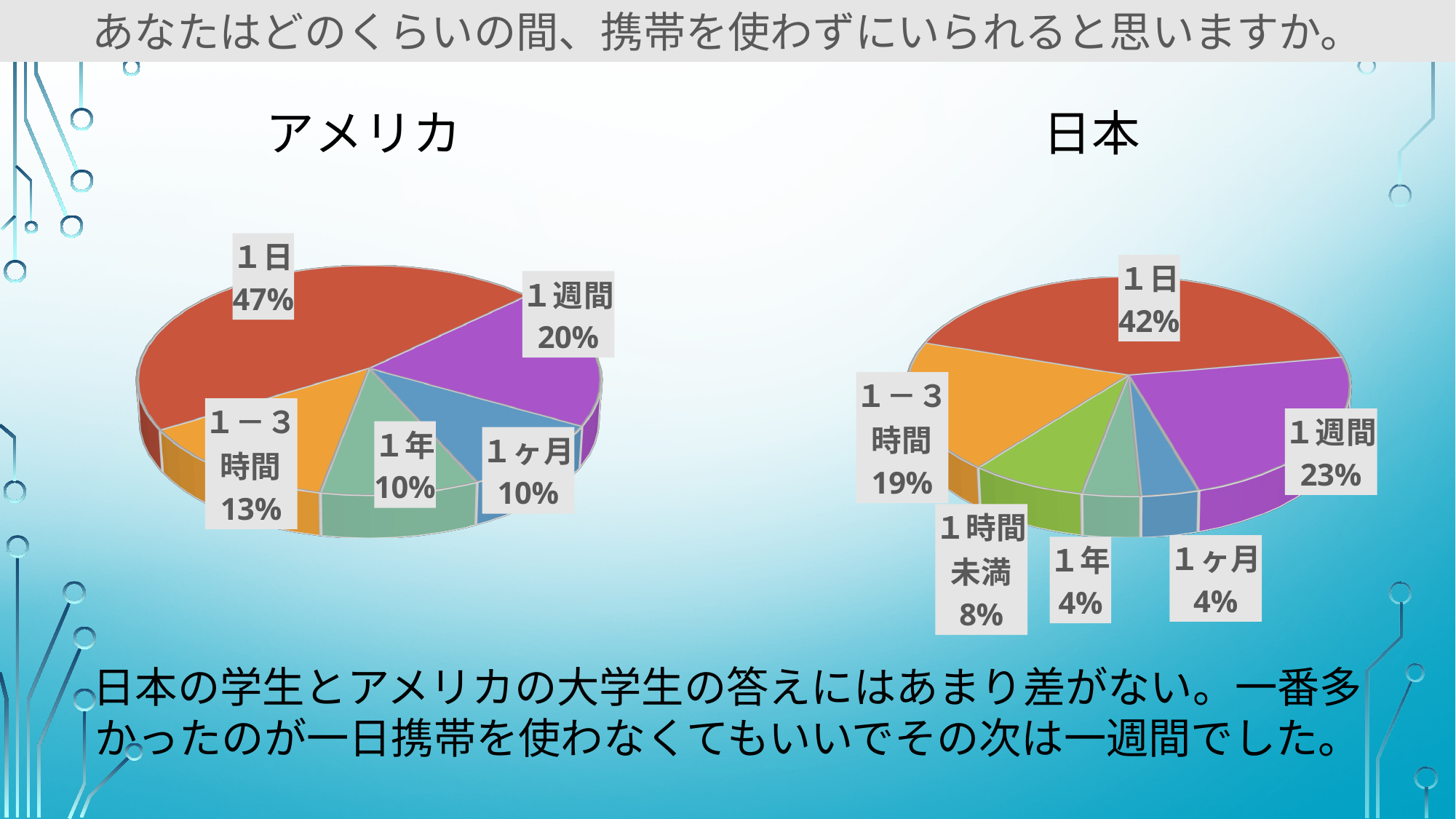
In the アメリカ chart, what share of respondents answered 1日? 47% In the 日本 chart, what is the difference between the 1－3時間 share and the 1時間未満 share? 11% In the アメリカ chart, which category has the largest share? 1日 In the 日本 chart, what share of respondents answered 1週間? 23% What type of chart is used for the アメリカ data? Pie chart Which chart shows a larger share for 1－3時間, アメリカ or 日本? 日本 In the 日本 chart, what share of respondents answered 1時間未満? 8% In the 日本 chart, which category has the largest share? 1日 In the 日本 chart, which category has the largest share after 1日? 1週間 How many categories are shown in the 日本 chart? 6 In the アメリカ chart, what share of respondents answered 1－3時間? 13% In the アメリカ chart, what is the difference between the 1日 share and the 1週間 share? 27%